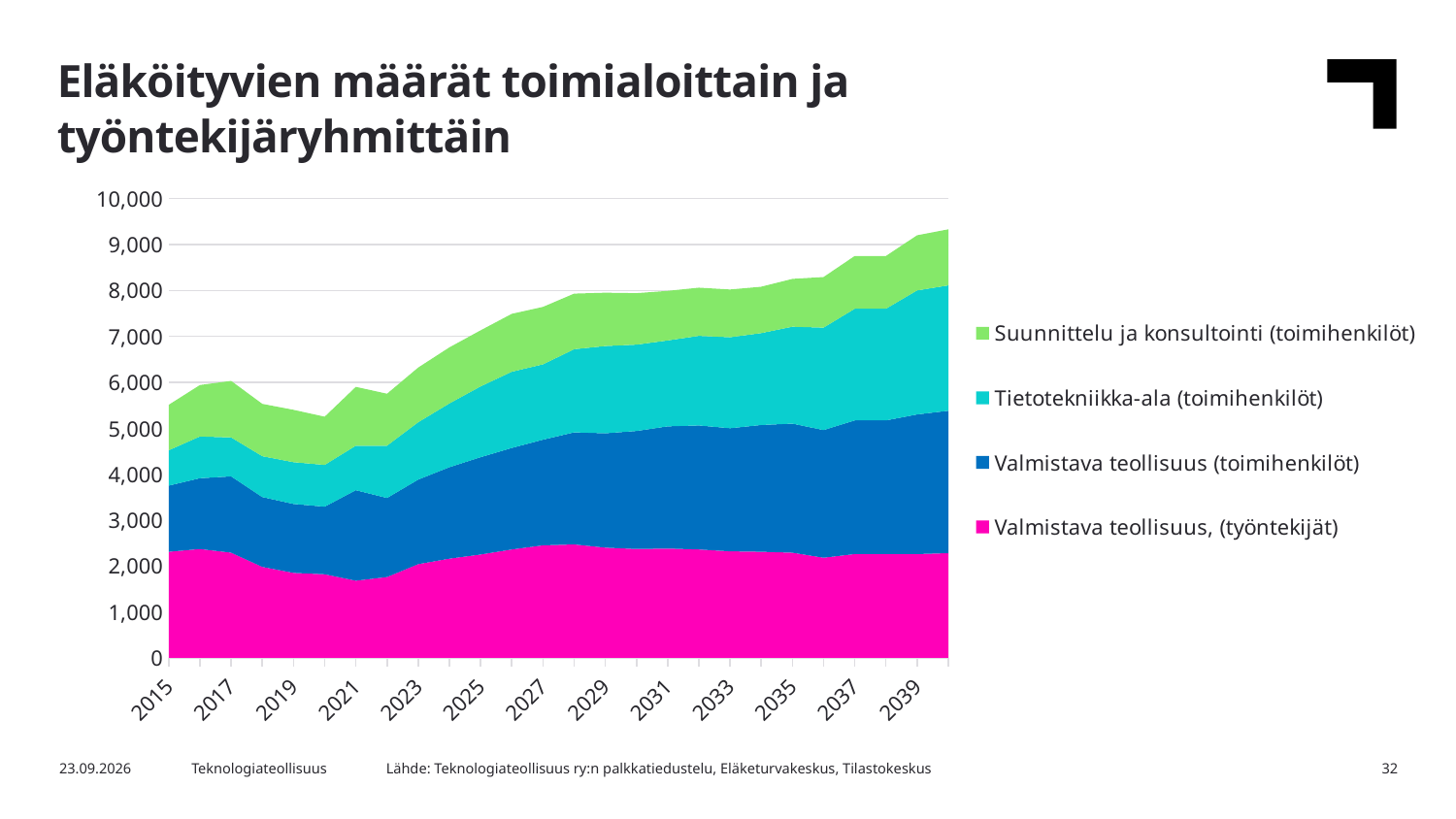
What kind of chart is shown on the slide? Stacked area chart Is the value for Valmistava teollisuus, (työntekijät) in 2021 greater or less than 2,000? less Is the total stacked value for 2039 greater or less than 8,000? greater How many series does the legend list? 4 How many year labels are shown on the x axis? 13 Is the total stacked value higher in 2015 or in 2039? 2039 Is the value for Valmistava teollisuus, (työntekijät) in 2015 greater or less than 2,000? greater Which series is shown in pink at the bottom of the stack? Valmistava teollisuus, (työntekijät) What is the title of the chart on the slide? Eläköityvien määrät toimialoittain ja työntekijäryhmittäin Does the total number of retirees rise or fall from 2015 to 2039 overall? rise